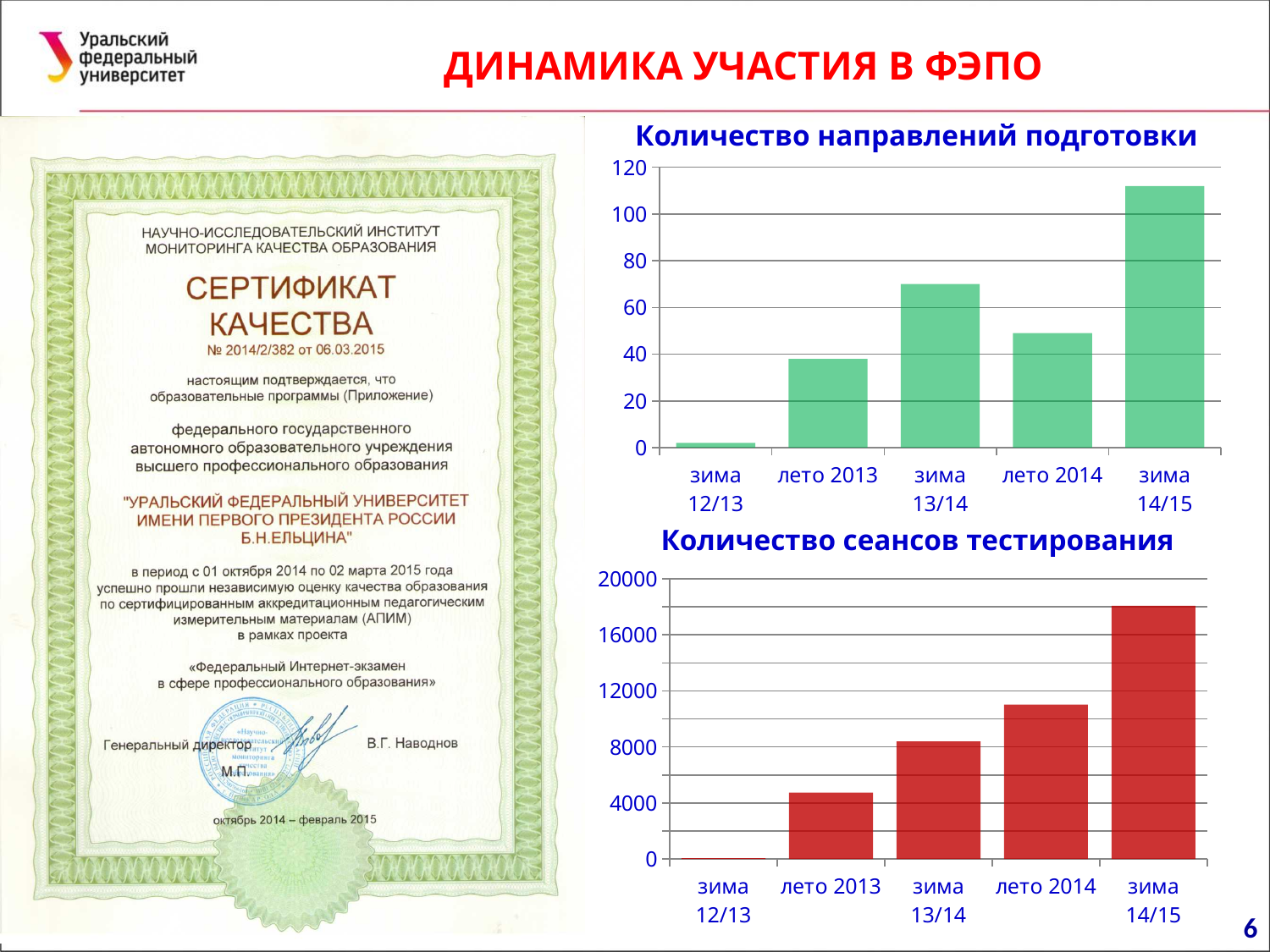
How many categories are shown on the x axis of the chart titled "Количество сеансов тестирования"? 5 In the chart titled "Количество сеансов тестирования", which category has the highest value? зима 14/15 What kind of chart is the chart titled "Количество направлений подготовки"? bar chart What is the title of the lower chart on the slide? Количество сеансов тестирования In the chart titled "Количество сеансов тестирования", do the values rise or fall from зима 12/13 to зима 14/15? rise In the chart titled "Количество направлений подготовки", is the value for зима 14/15 greater or less than 100? greater In the chart titled "Количество сеансов тестирования", is the value for лето 2013 greater or less than 8000? less In the chart titled "Количество направлений подготовки", which is larger: the value for зима 13/14 or the value for лето 2014? зима 13/14 In the chart titled "Количество сеансов тестирования", is the value for зима 14/15 greater or less than 16000? greater In the chart titled "Количество направлений подготовки", which category has the highest value? зима 14/15 In the chart titled "Количество направлений подготовки", which category has the lowest value? зима 12/13 In the chart titled "Количество сеансов тестирования", which category has the lowest value? зима 12/13